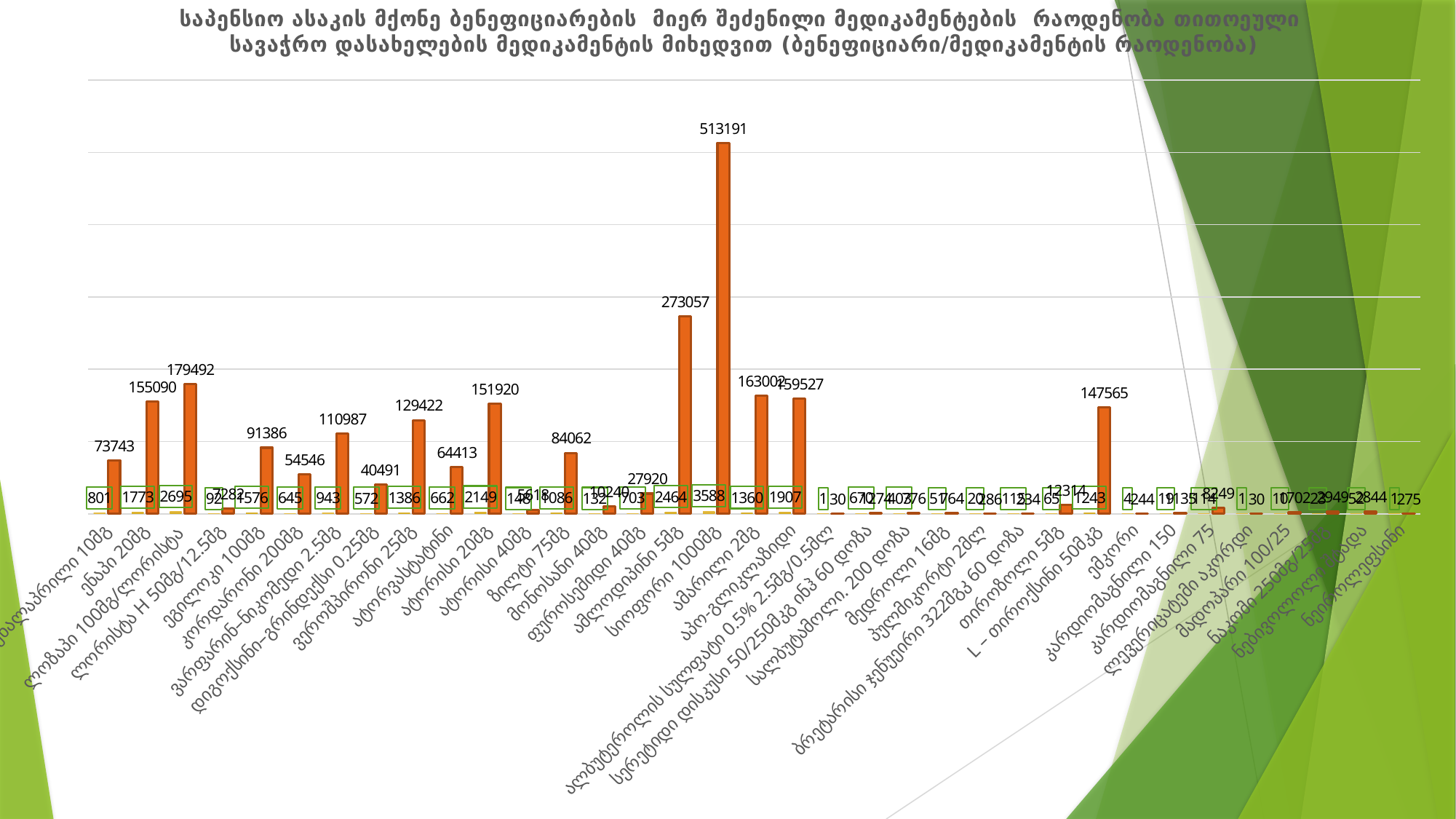
What is the value shown for ენაპი 20მგ? 155090 Which is larger, the value for ამარილი 2მგ or the value for კორდარონი 200მგ? ამარილი 2მგ What is the value shown for ზილტი 75მგ? 84062 What is the value shown for ამლოდიპინი 5მგ? 273057 Which is larger, the value for ენაპი 20მგ or the value for ლოზაპი 100მგ/ლორისტა? ლოზაპი 100მგ/ლორისტა What is the smaller boxed number shown for სიოფორი 1000მგ (the beneficiary count)? 3588 What is the value of the tallest bar, for სიოფორი 1000მგ? 513191 What is the difference between the values for სიოფორი 1000მგ and ამლოდიპინი 5მგ? 240134 What kind of chart is shown on the slide? bar chart What is the value shown for ლოზაპი 100მგ/ლორისტა? 179492 Which category has the highest bar in the chart? სიოფორი 1000მგ What is the value shown for ვეროშპირონი 25მგ? 129422